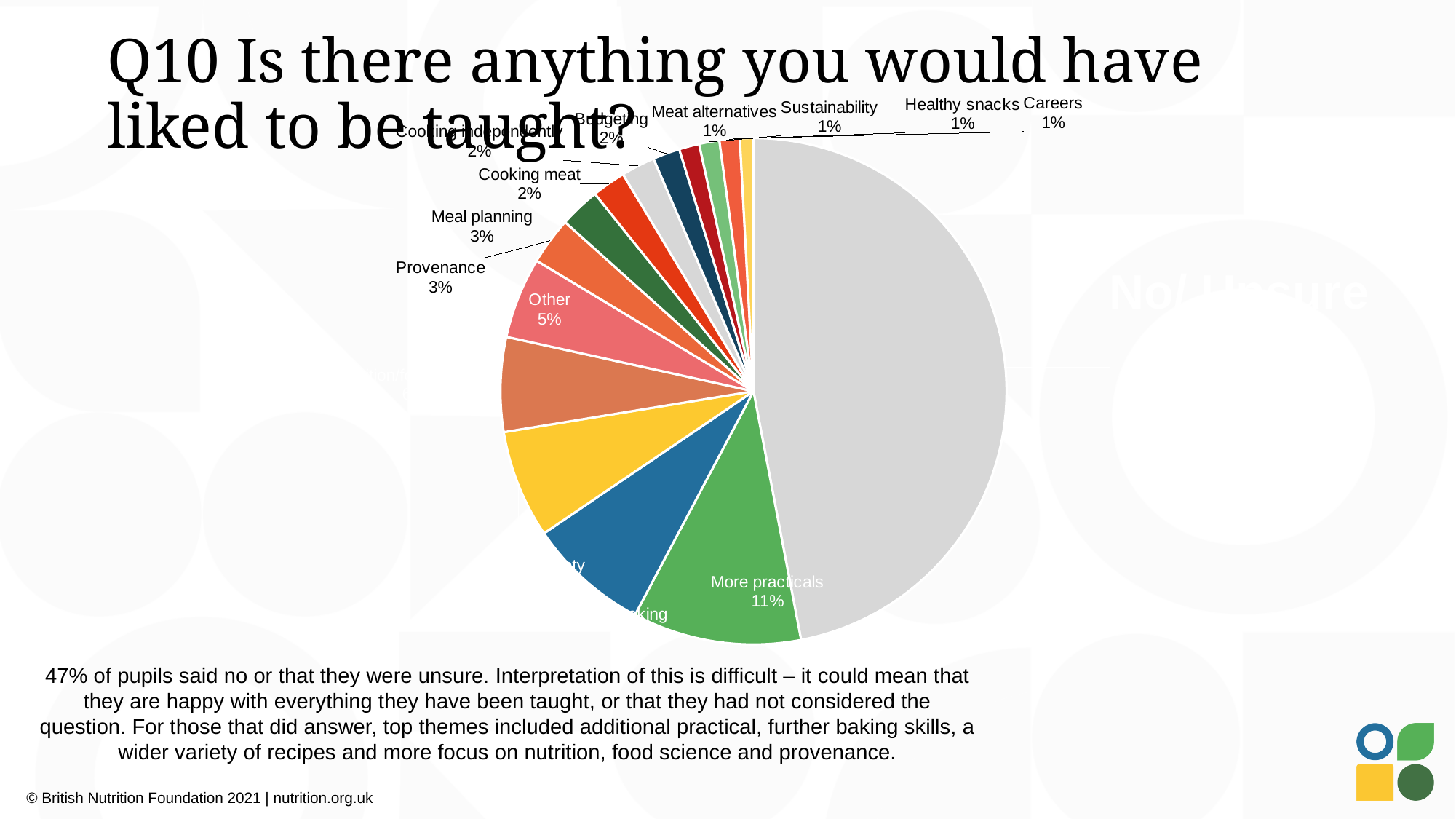
What kind of chart is shown on the slide? Pie chart What percentage is shown for 'Provenance'? 3% What percentage is shown for 'Sustainability'? 1% How many percentage points larger is 'More practicals' than 'Other'? 6 Which slice is larger, 'More practicals' or 'Other'? More practicals According to the slide, what share of pupils said no or that they were unsure? 47% What share of the pie does the 'Other' slice represent? 5% What is the title of the slide containing the pie chart? Q10 Is there anything you would have liked to be taught? What percentage is shown for 'Meal planning'? 3% What percentage is shown for 'Cooking meat'? 2% What percentage is shown for 'Careers'? 1% What percentage of the pie is labelled 'More practicals'? 11%